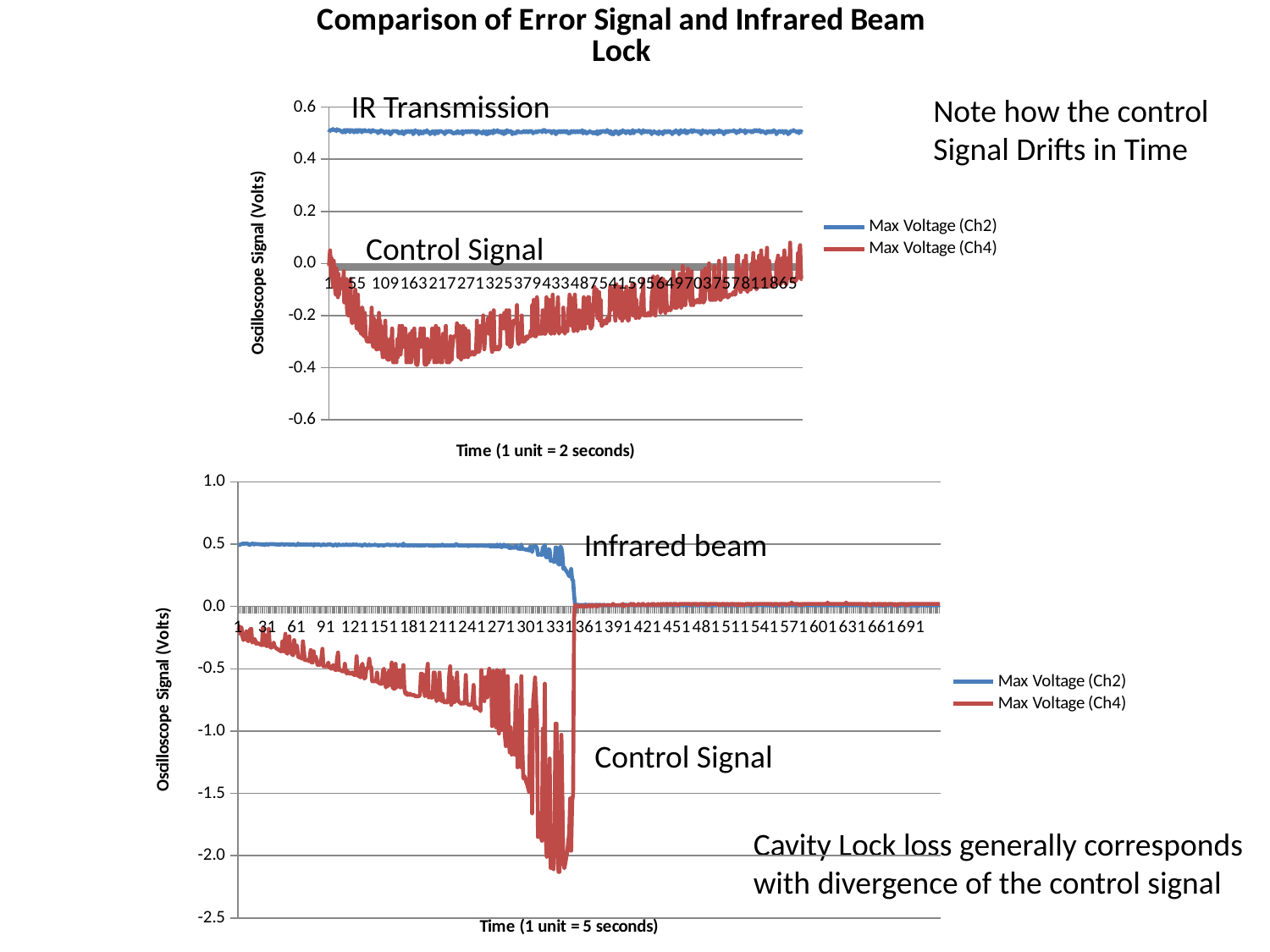
In the top chart, is the value of the Max Voltage (Ch2) series greater or less than 0.4? greater What is the y-axis title of the top chart? Oscilloscope Signal (Volts) In the bottom chart, is the lowest value reached by the Max Voltage (Ch4) series greater or less than -1.5? less What kind of chart is the top chart on the slide? line chart In the top chart, which series has the higher values, Max Voltage (Ch2) or Max Voltage (Ch4)? Max Voltage (Ch2) What kind of chart is the bottom chart on the slide? line chart In the top chart, is the lowest value reached by the Max Voltage (Ch4) series greater or less than -0.2? less How many series does the legend of the bottom chart list? 2 How many series does the legend of the top chart list? 2 What is the x-axis title of the bottom chart? Time (1 unit = 5 seconds) In the bottom chart, does the Max Voltage (Ch2) series rise or fall around time unit 331 to 361? fall